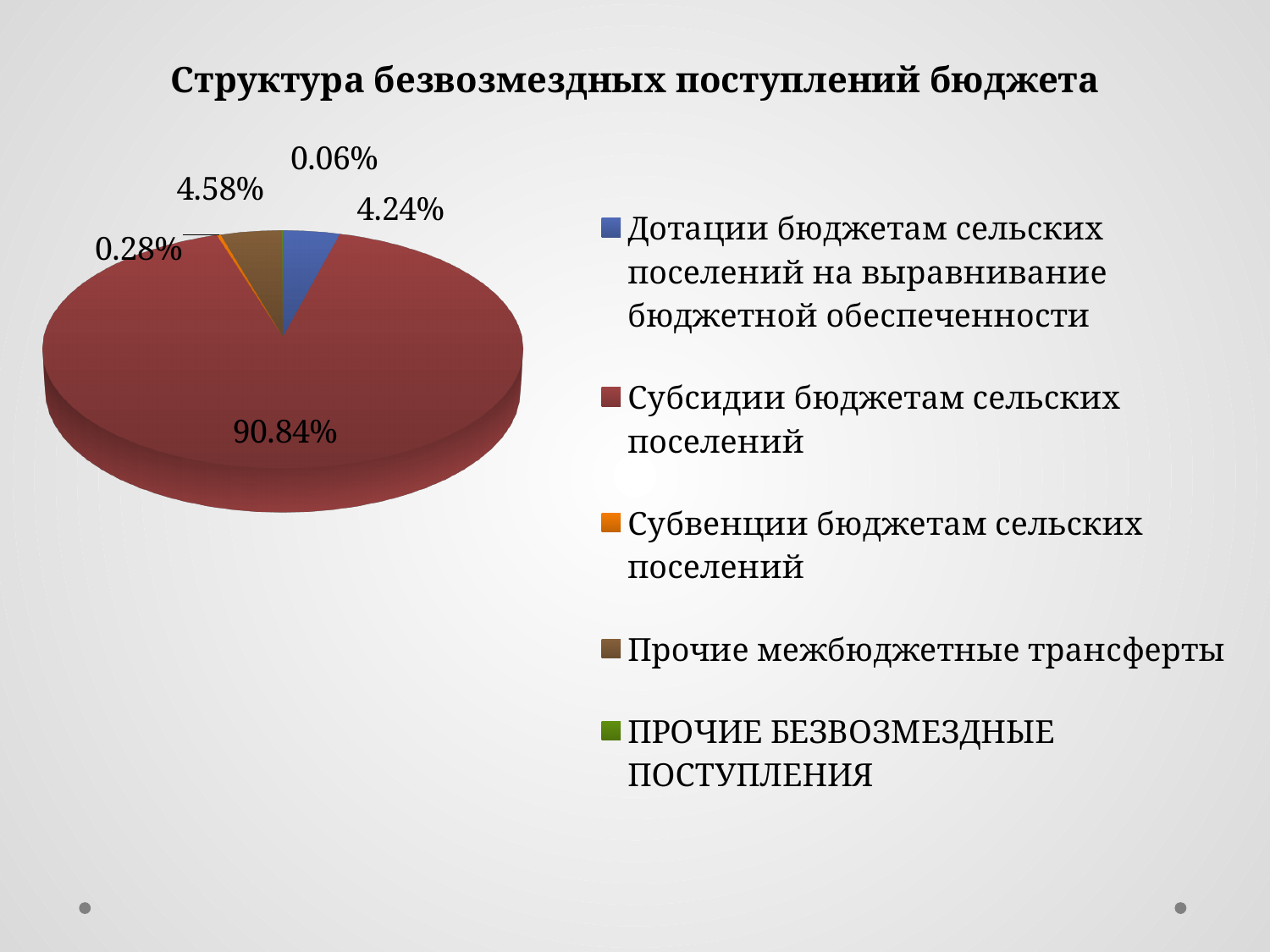
How many categories does the legend list? 5 What share of the pie is 'Субвенции бюджетам сельских поселений'? 0.28% Which category has the smallest share of the pie? ПРОЧИЕ БЕЗВОЗМЕЗДНЫЕ ПОСТУПЛЕНИЯ Which is larger: the share for 'Прочие межбюджетные трансферты' or the share for 'Дотации бюджетам сельских поселений на выравнивание бюджетной обеспеченности'? Прочие межбюджетные трансферты What share of the pie is 'Субсидии бюджетам сельских поселений'? 90.84% What share of the pie is 'ПРОЧИЕ БЕЗВОЗМЕЗДНЫЕ ПОСТУПЛЕНИЯ'? 0.06% What kind of chart is shown on the slide? pie chart What is the difference between the share for 'Прочие межбюджетные трансферты' and the share for 'Субвенции бюджетам сельских поселений'? 4.30% Which category has the largest share of the pie? Субсидии бюджетам сельских поселений What is the title of the chart? Структура безвозмездных поступлений бюджета